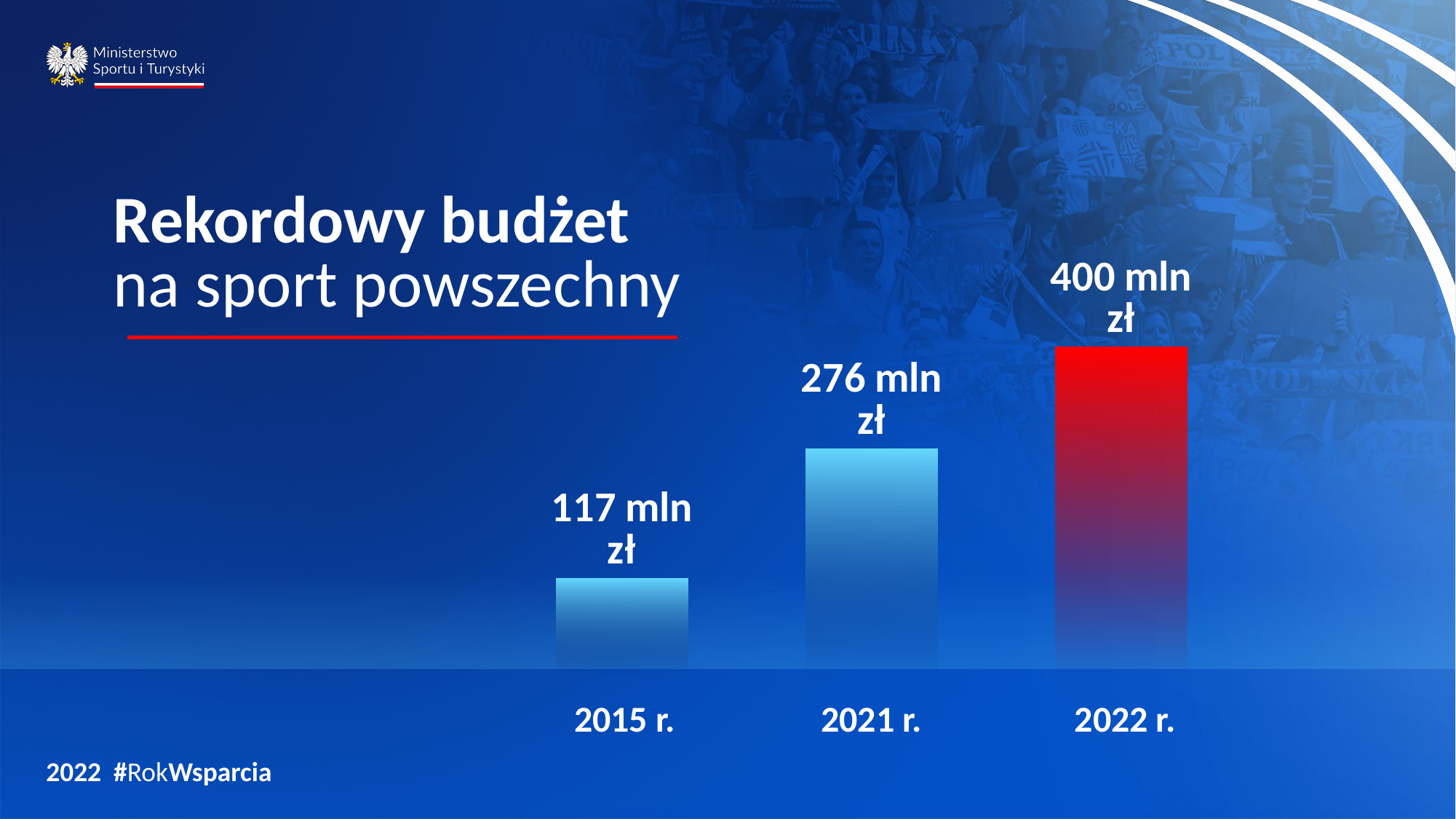
Do the values rise or fall from 2015 r. to 2022 r.? rise What is the budget value shown for 2021 r.? 276 mln zł Which year has the highest budget value? 2022 r. Which is larger, the value for 2015 r. or the value for 2021 r.? 2021 r. Which year has the lowest budget value? 2015 r. Which bar is coloured red rather than blue? 2022 r. What is the budget value shown for 2015 r.? 117 mln zł What is the budget value shown for 2022 r.? 400 mln zł What kind of chart is shown on the slide? bar chart What is the difference between the 2022 r. and 2021 r. values? 124 mln zł What is the difference between the 2021 r. and 2015 r. values? 159 mln zł How many years (bars) are shown in the chart? 3